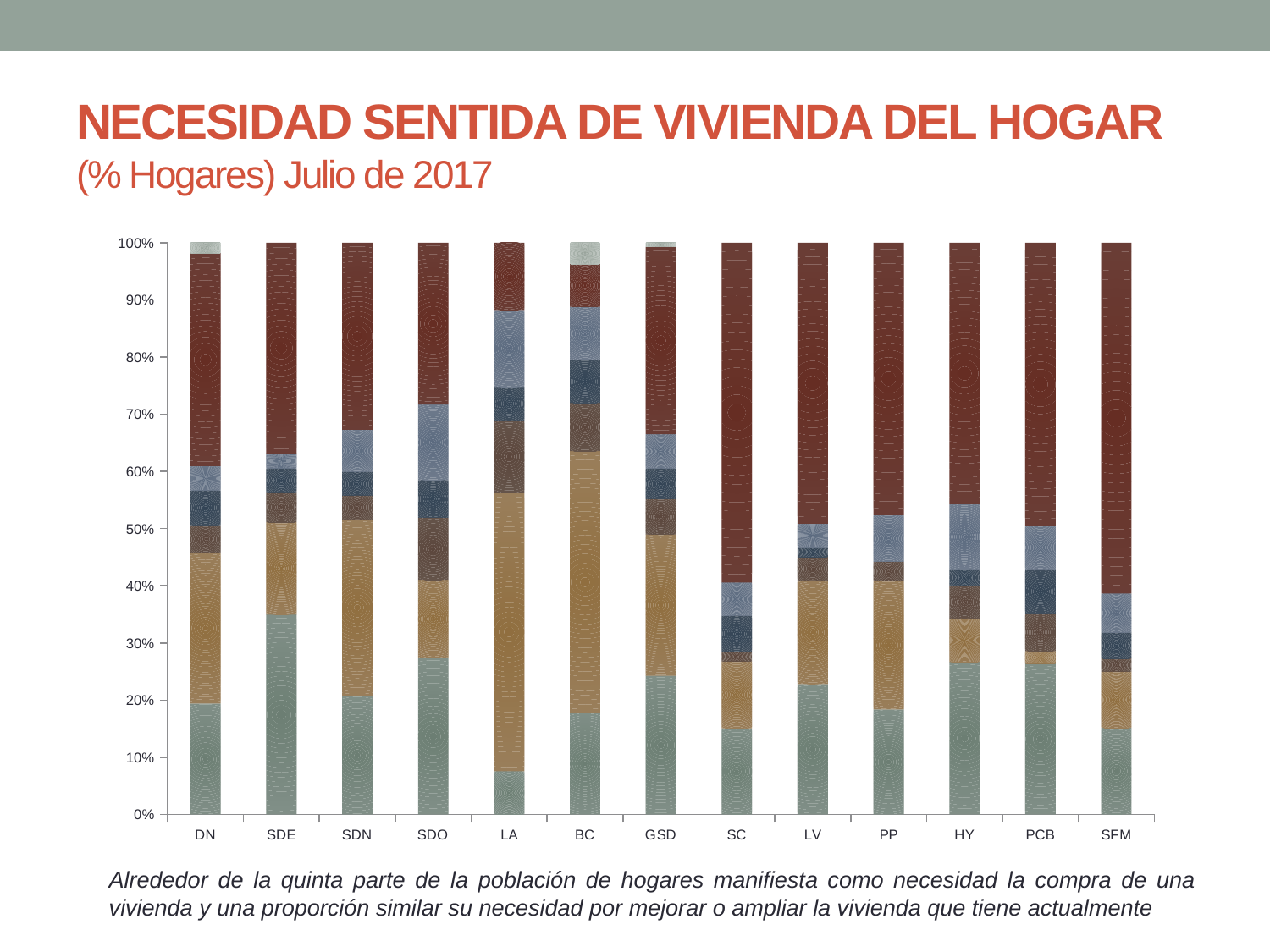
What is the title of the chart on the slide? NECESIDAD SENTIDA DE VIVIENDA DEL HOGAR Which category has the largest top (dark red) segment? SFM Which category has the smallest bottom (green) segment? LA Is the value of the bottom (green) segment for SDE greater or less than 30%? greater Is the value of the top (dark red) segment for SFM greater or less than 50%? greater What kind of chart is shown on the slide? Stacked bar chart What is the total of the stacked bar for DN? 100% Which category has the largest bottom (green) segment? SDE Which category has the smallest top (dark red) segment? BC How many categories are shown along the x axis of the chart? 13 Is the bottom (green) segment larger for SDE or for LA? SDE Is the value of the bottom (green) segment for LA greater or less than 10%? less